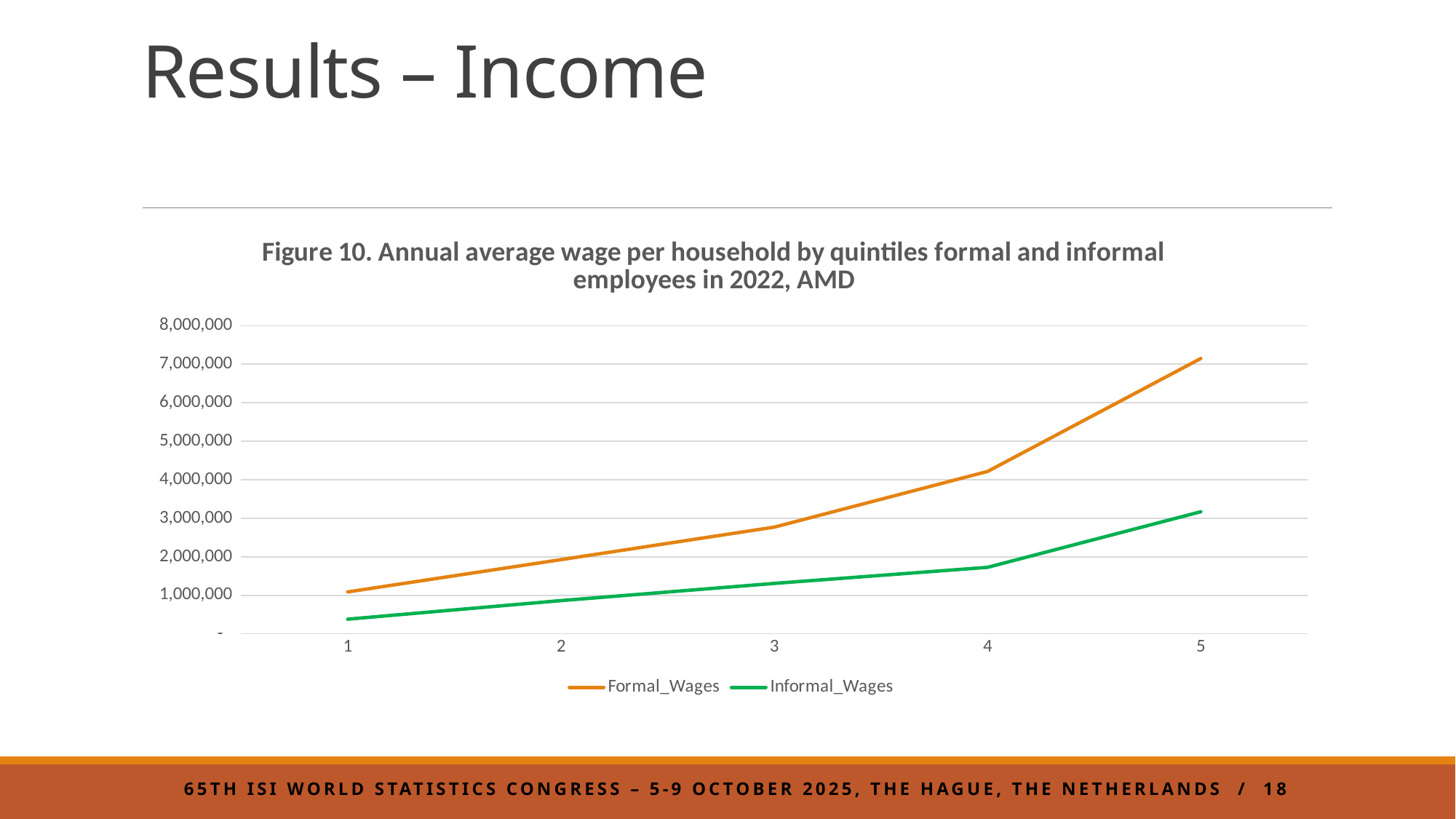
What colour is the Informal_Wages line? green What kind of chart is shown on the slide? line chart Is the Informal_Wages value for quintile 4 greater or less than 2,000,000? less Which series is higher at quintile 3, Formal_Wages or Informal_Wages? Formal_Wages Do the Formal_Wages values rise or fall from quintile 1 to quintile 5? rise Is the Formal_Wages value for quintile 5 greater or less than 6,000,000? greater Which quintile has the highest Formal_Wages value? 5 How many quintiles are plotted along the x axis? 5 How many series does the legend list? 2 Which quintile has the lowest Informal_Wages value? 1 Is the Informal_Wages value for quintile 1 greater or less than 1,000,000? less